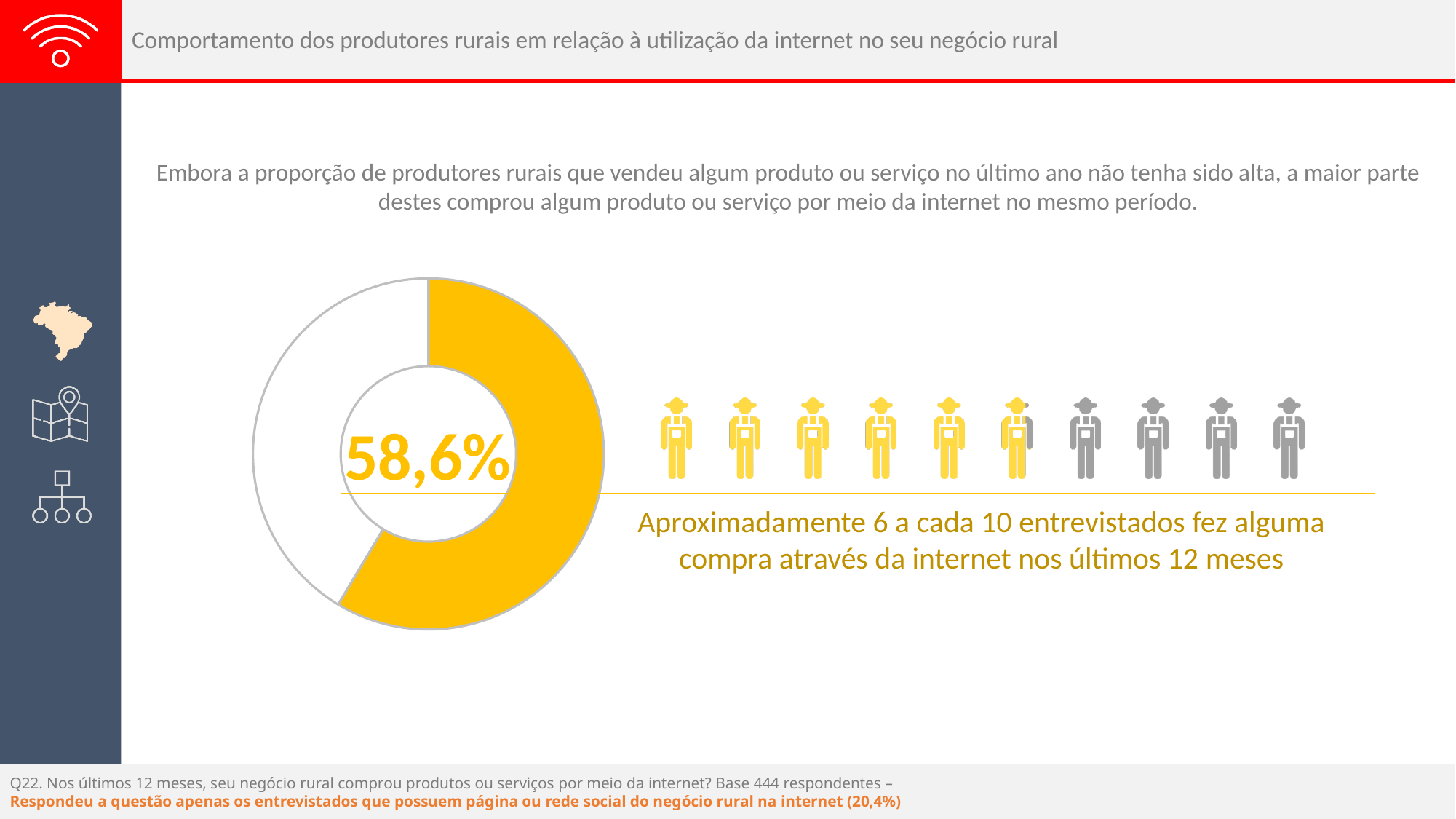
What kind of chart is shown on the left of the slide? donut chart What percentage is shown in the centre of the donut chart? 58,6% What colour is the slice of the donut chart that represents 58,6%? yellow How many person icons are shown in the pictogram to the right of the donut chart? 10 How many of the person icons in the pictogram are coloured grey? 4 How many respondents form the base for the question shown in the footnote? 444 In the donut chart, which slice is larger, the yellow one or the white one? the yellow one Is the yellow slice of the donut chart greater or less than half of the chart? greater According to the text next to the pictogram, approximately how many out of every 10 respondents made a purchase through the internet in the last 12 months? 6 How many of the person icons in the pictogram are coloured yellow? 6